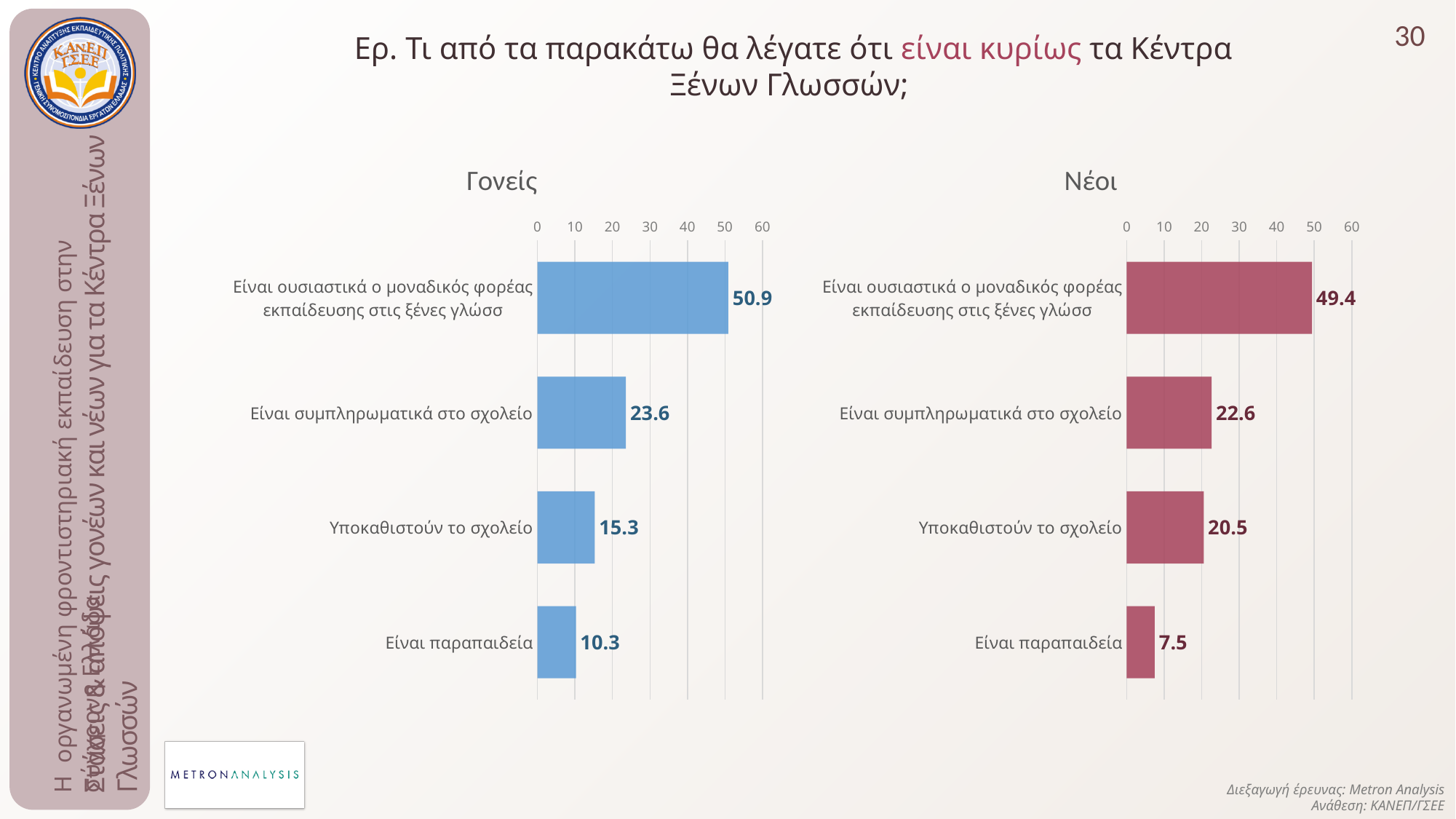
In the Γονείς chart, what is the difference between 'Είναι ουσιαστικά ο μοναδικός φορέας εκπαίδευσης στις ξένες γλώσσ' and 'Είναι συμπληρωματικά στο σχολείο'? 27.3 In the Νέοι chart, what is the value for 'Είναι παραπαιδεία'? 7.5 In the Νέοι chart, what is the value for 'Υποκαθιστούν το σχολείο'? 20.5 In the Γονείς chart, what is the value for 'Είναι συμπληρωματικά στο σχολείο'? 23.6 What colour are the bars in the Νέοι chart? red What kind of chart is the Γονείς chart? bar chart Which is larger: the value for 'Υποκαθιστούν το σχολείο' in the Γονείς chart or in the Νέοι chart? Νέοι In the Γονείς chart, which category has the highest value? Είναι ουσιαστικά ο μοναδικός φορέας εκπαίδευσης στις ξένες γλώσσ How many categories does the Νέοι chart show? 4 In the Νέοι chart, which category has the lowest value? Είναι παραπαιδεία In the Γονείς chart, is the value for 'Είναι παραπαιδεία' greater or less than 20? less In the Νέοι chart, what is the difference between 'Είναι συμπληρωματικά στο σχολείο' and 'Υποκαθιστούν το σχολείο'? 2.1